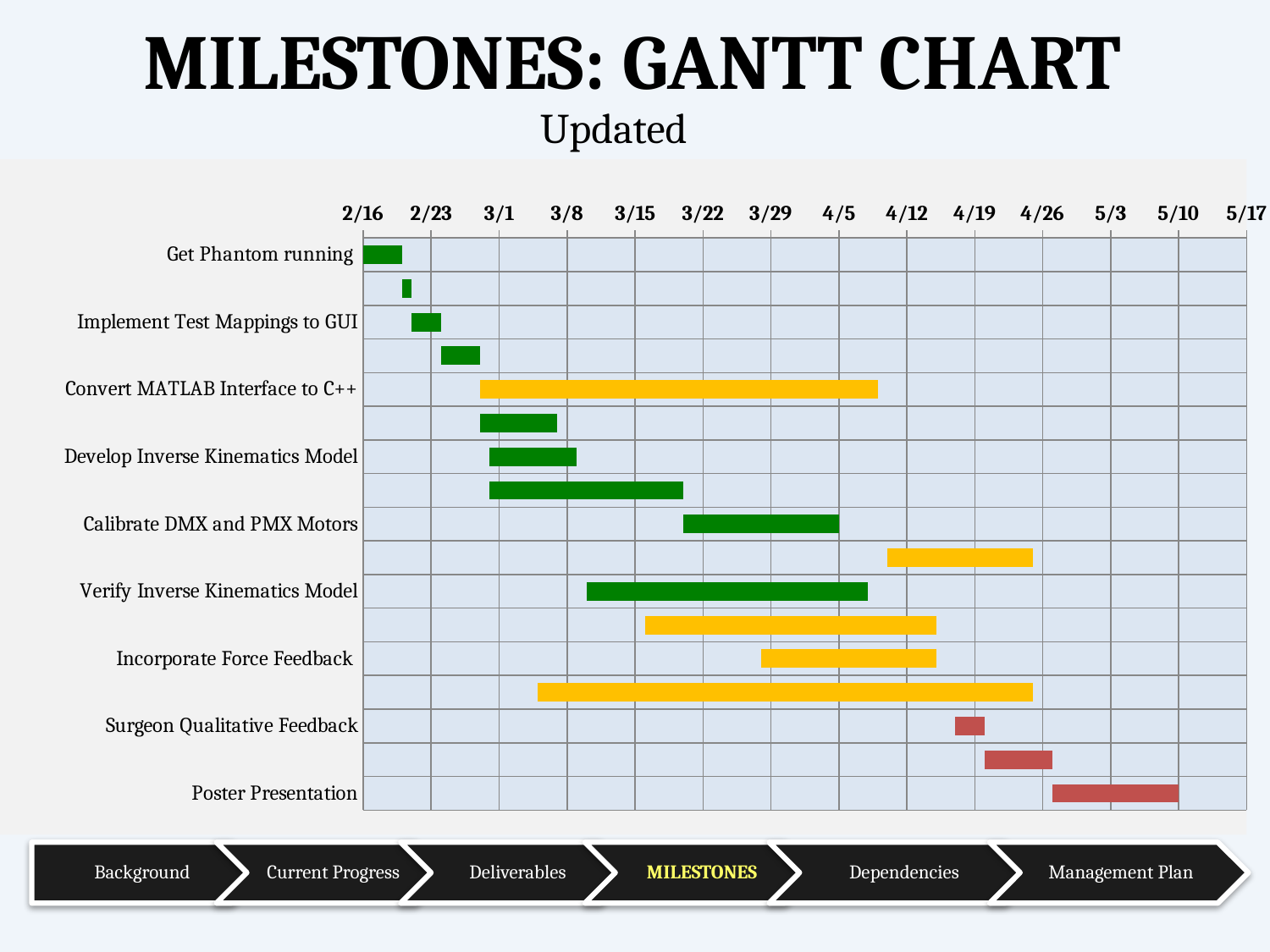
How many task labels are listed on the left side of the Gantt chart? 9 Does the 'Convert MATLAB Interface to C++' bar end before or after 4/5? after What kind of chart is shown on the slide? Gantt chart (horizontal bar chart) Which labeled task has the latest bar on the timeline? Poster Presentation What is the first date shown on the Gantt chart's time axis? 2/16 How many date ticks are shown along the top axis of the Gantt chart? 14 Which labeled task has the earliest bar on the timeline? Get Phantom running Does the 'Poster Presentation' bar start before or after 4/19? after What is the last date shown on the Gantt chart's time axis? 5/17 Which labeled task has the longest bar: 'Convert MATLAB Interface to C++' or 'Get Phantom running'? Convert MATLAB Interface to C++